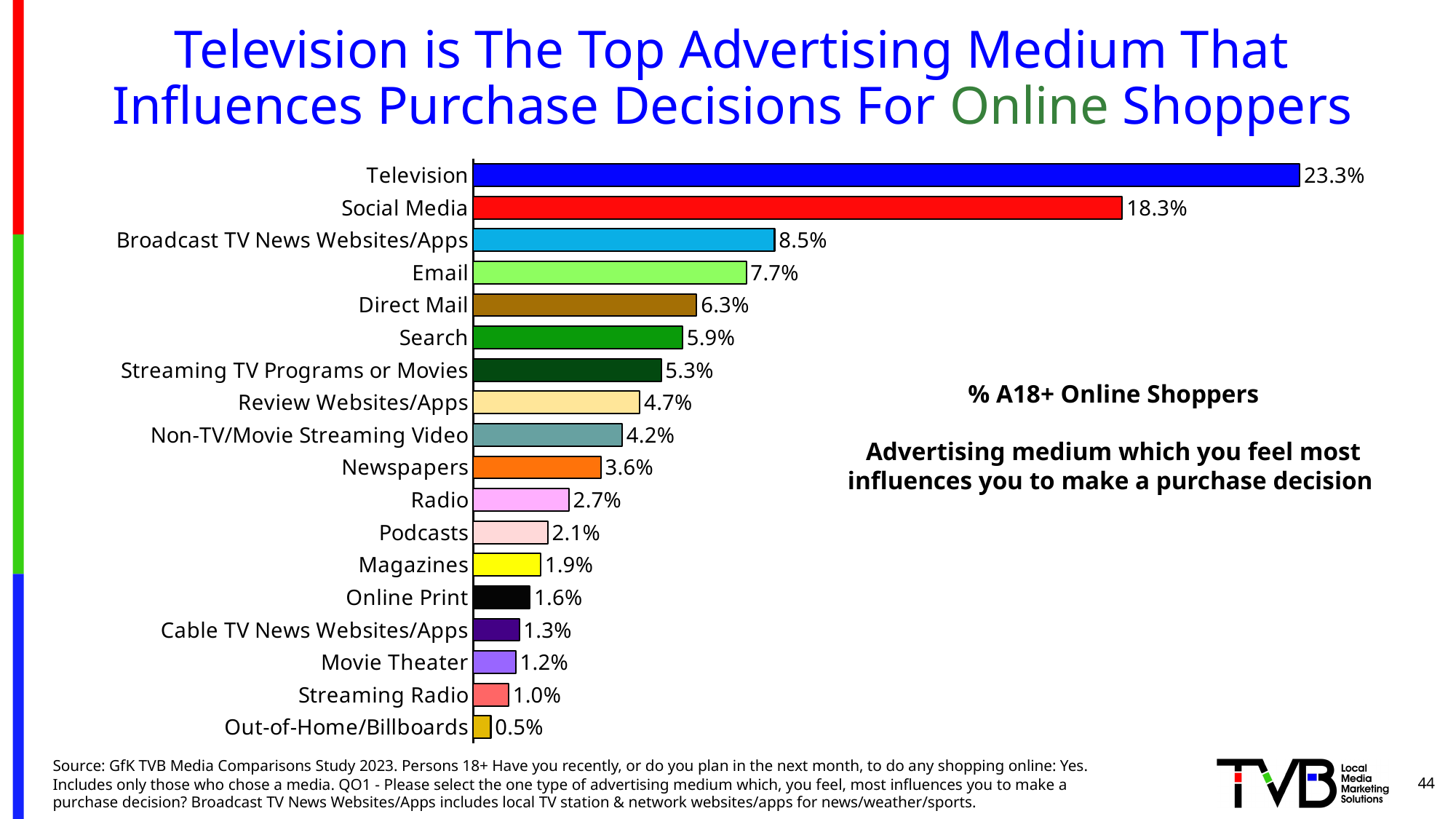
Which has a larger value, Email or Broadcast TV News Websites/Apps? Broadcast TV News Websites/Apps Which advertising medium has the lowest value on the chart? Out-of-Home/Billboards What colour is the bar for Television? Blue What is the difference between the values for Newspapers and Radio? 0.9% What is the value shown for Out-of-Home/Billboards? 0.5% What is the difference between the values for Television and Social Media? 5.0% What percentage of A18+ online shoppers chose Television as the advertising medium that most influences their purchase decision? 23.3% What is the value shown for Direct Mail? 6.3% How many advertising media categories are shown on the chart? 18 Which advertising medium has the highest value on the chart? Television What is the value shown for Social Media? 18.3% What kind of chart is shown on the slide? Bar chart